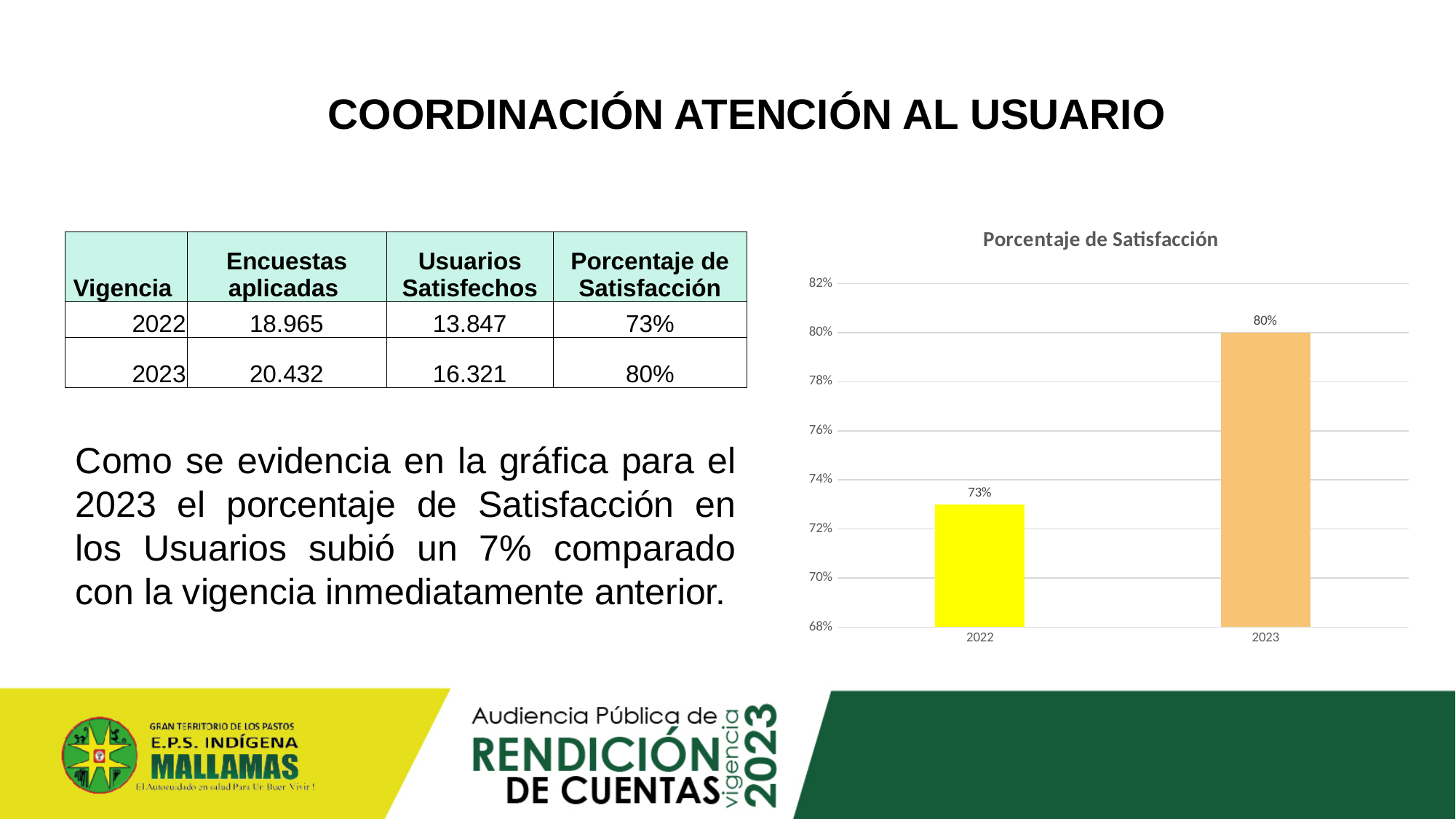
Do the values in the Porcentaje de Satisfacción chart rise or fall from 2022 to 2023? rise Is the value for 2022 in the Porcentaje de Satisfacción chart greater or less than 74%? less Is the value for 2023 in the Porcentaje de Satisfacción chart greater or less than 78%? greater How many categories are shown on the x axis of the Porcentaje de Satisfacción chart? 2 What is the value for 2022 in the Porcentaje de Satisfacción chart? 73% Which is larger in the Porcentaje de Satisfacción chart, the value for 2022 or for 2023? 2023 Which year has the highest value in the Porcentaje de Satisfacción chart? 2023 What is the difference between the 2023 and 2022 values in the Porcentaje de Satisfacción chart? 7% What is the value for 2023 in the Porcentaje de Satisfacción chart? 80% What is the title of the chart on the slide? Porcentaje de Satisfacción Which year has the lowest value in the Porcentaje de Satisfacción chart? 2022 What kind of chart is the Porcentaje de Satisfacción chart? bar chart